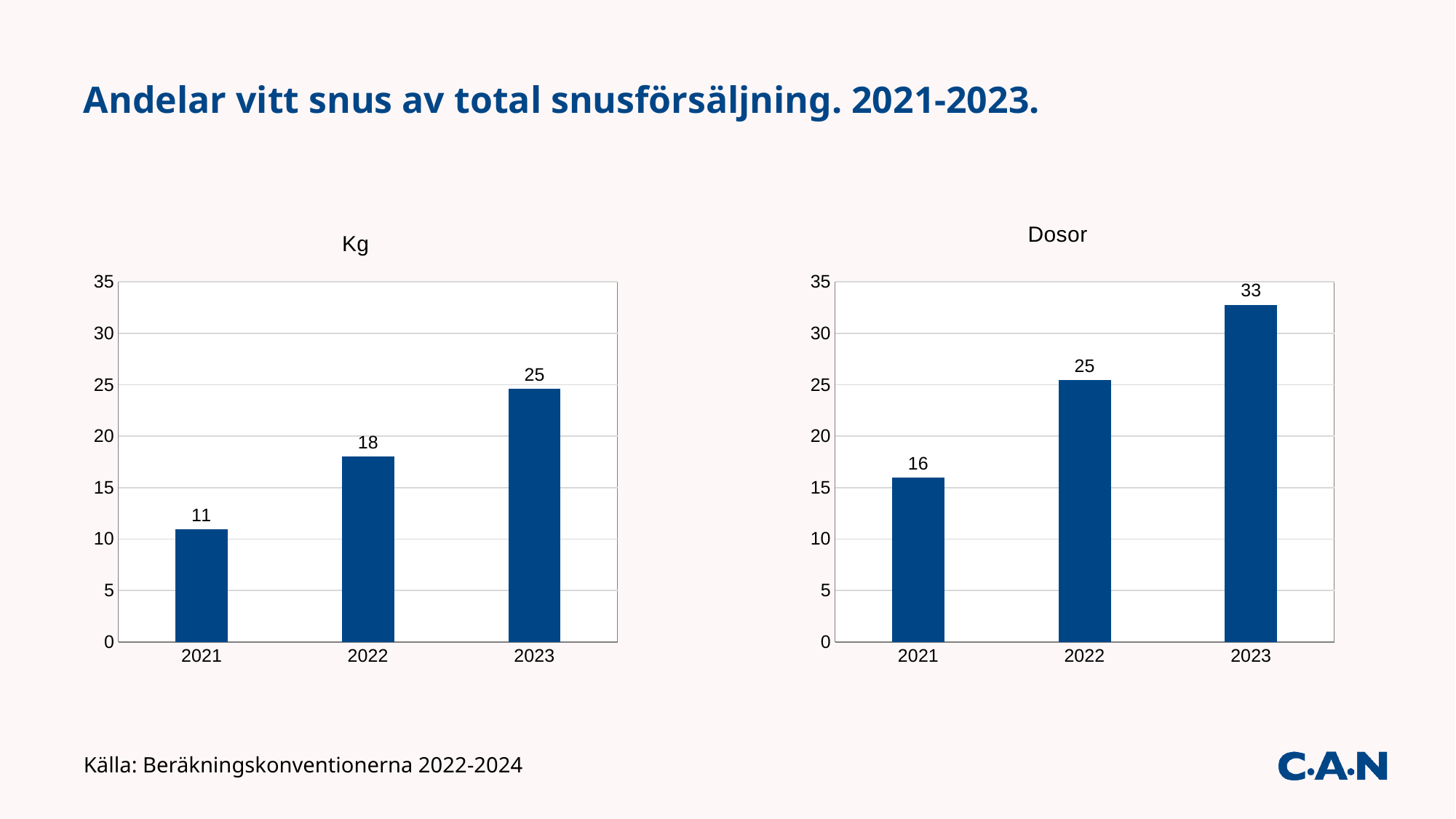
In the "Kg" chart, what is the value for 2023? 25 What kind of chart is the "Dosor" chart? Bar chart In the "Kg" chart, what is the difference between the values for 2023 and 2021? 14 In the "Kg" chart, how many years are shown on the x axis? 3 In the "Dosor" chart, what is the difference between the values for 2023 and 2022? 8 In the "Dosor" chart, what is the value for 2022? 25 Which is larger: the 2021 value in the "Kg" chart or the 2021 value in the "Dosor" chart? Dosor In the "Kg" chart, which year has the lowest value? 2021 In the "Kg" chart, what is the value for 2021? 11 In the "Dosor" chart, what is the value for 2023? 33 In the "Dosor" chart, do the values rise or fall from 2021 to 2023? Rise In the "Dosor" chart, which year has the highest value? 2023